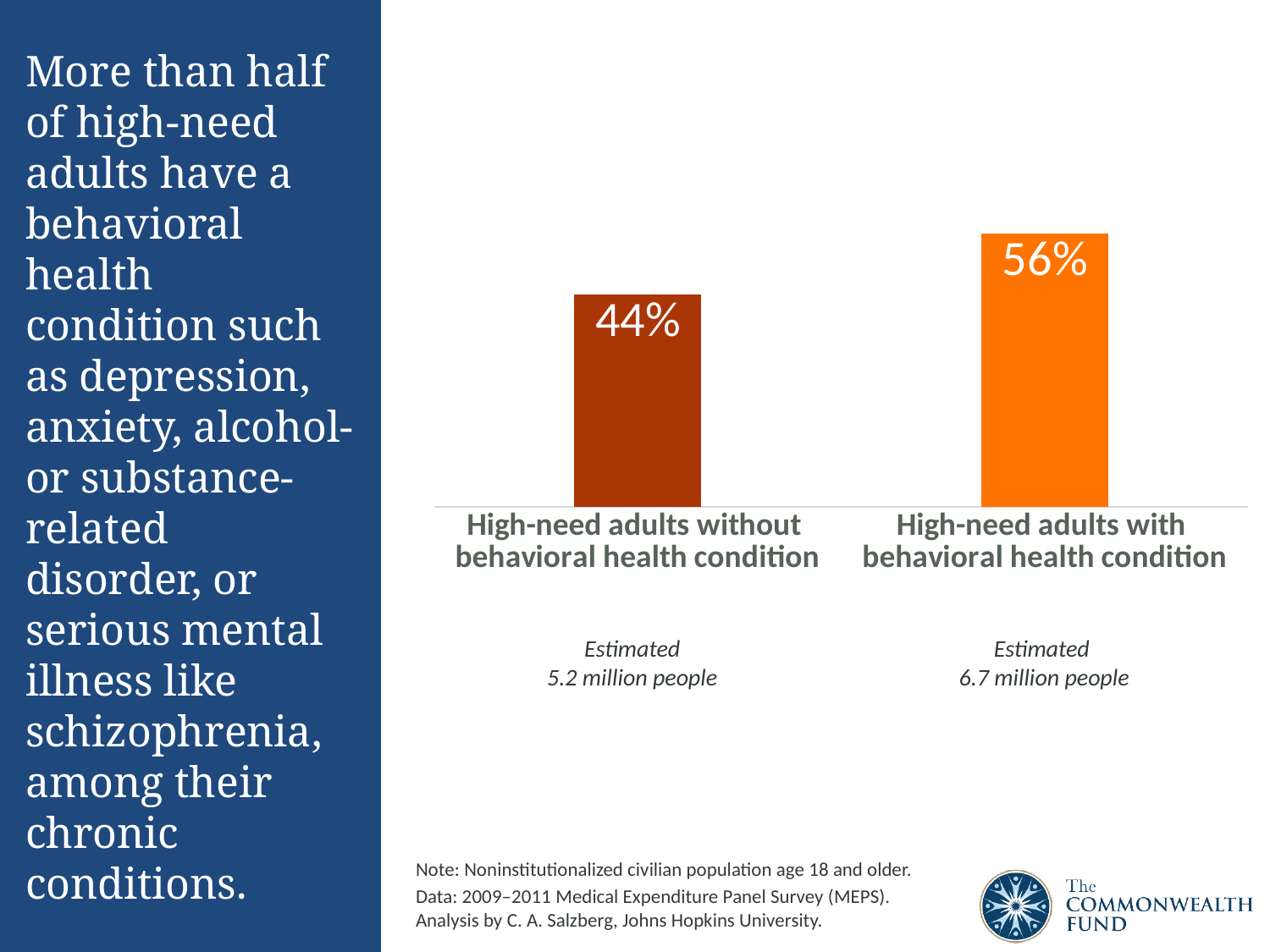
What is the value for high-need adults with behavioral health condition? 56% What kind of chart is shown on the slide? Bar chart Which category has the lowest value? High-need adults without behavioral health condition Which is larger: the value for high-need adults with behavioral health condition or without behavioral health condition? High-need adults with behavioral health condition What is the estimated number of people for high-need adults without behavioral health condition? 5.2 million people How many categories are shown in the chart? 2 What is the difference between the values for high-need adults with and without a behavioral health condition? 12% Which category has the highest value? High-need adults with behavioral health condition What is the total of the two bar values? 100% What is the value for high-need adults without behavioral health condition? 44% What is the estimated number of people for high-need adults with behavioral health condition? 6.7 million people